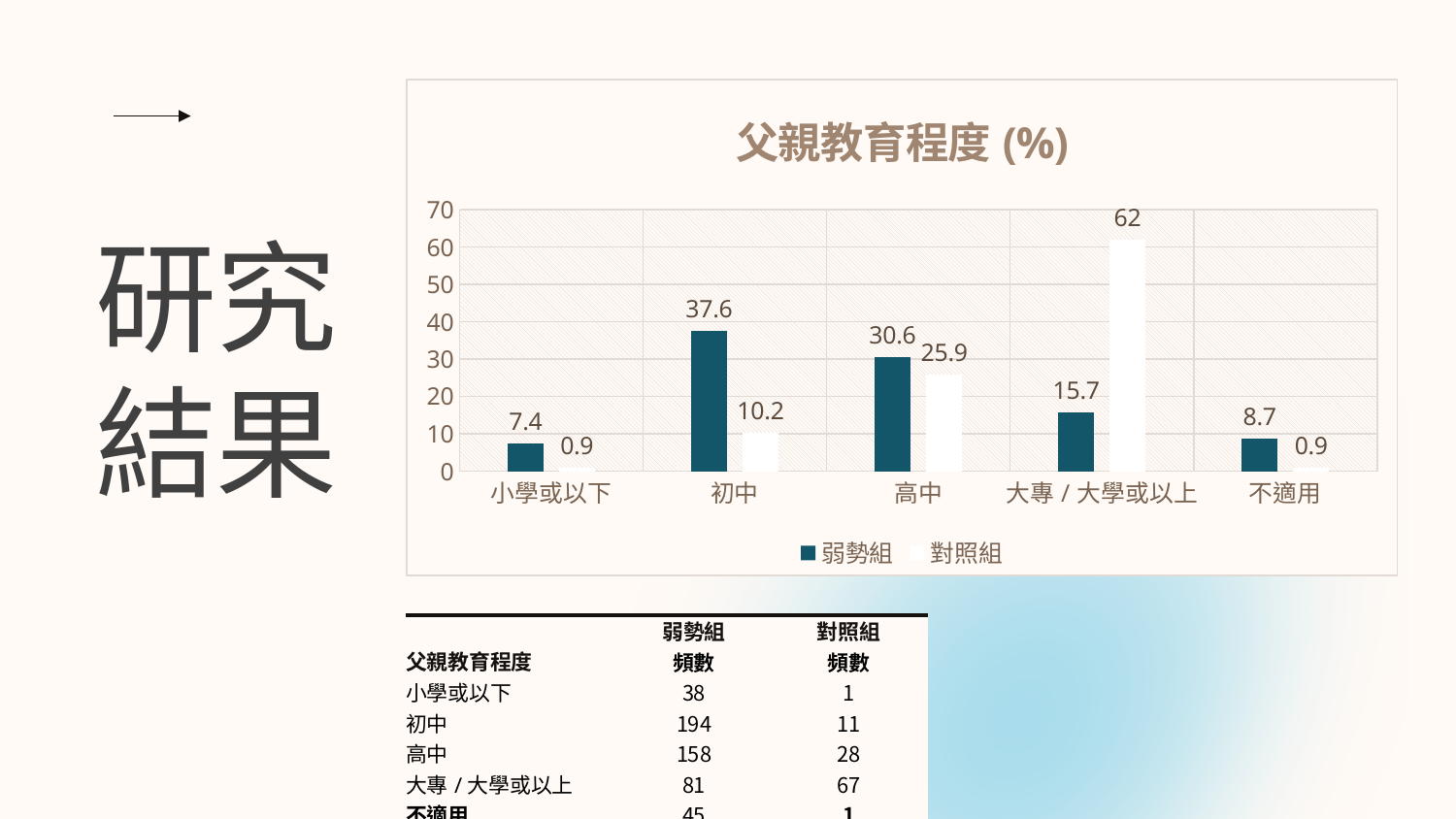
Which category has the highest value for 弱勢組? 初中 Which category has the lowest value for 弱勢組? 小學或以下 What is the value for 對照組 in the 大專 / 大學或以上 category? 62 How many categories are shown on the x axis? 5 In the 大專 / 大學或以上 category, which series has the larger value, 弱勢組 or 對照組? 對照組 What is the value for 弱勢組 in the 初中 category? 37.6 What is the difference between 弱勢組 and 對照組 in the 初中 category? 27.4 What is the title of the chart? 父親教育程度 (%) What is the value for 對照組 in the 高中 category? 25.9 What kind of chart is shown? bar chart Which category has the highest value for 對照組? 大專 / 大學或以上 How many series does the legend list? 2